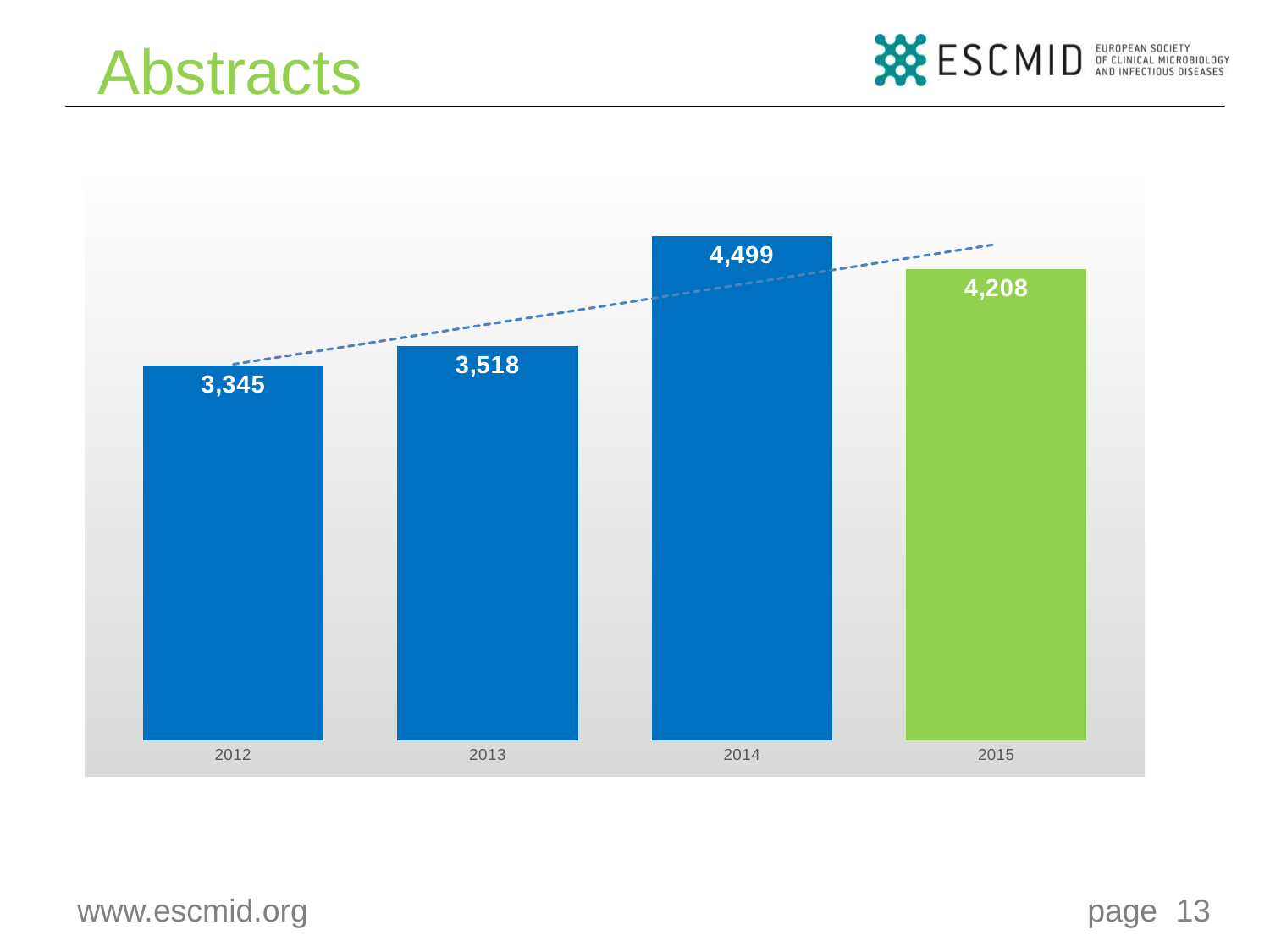
What is the difference between the values for 2013 and 2012? 173 How many years are shown on the chart? 4 What is the number of abstracts for 2014? 4,499 What kind of chart is shown on the slide? bar chart Which bar is coloured green rather than blue? 2015 Which year has the highest number of abstracts? 2014 What is the difference between the values for 2014 and 2015? 291 What is the number of abstracts for 2012? 3,345 What is the value shown for 2015? 4,208 Do the values rise or fall from 2012 to 2014? rise Which year has the lowest number of abstracts? 2012 Which is larger, the value for 2013 or the value for 2015? 2015